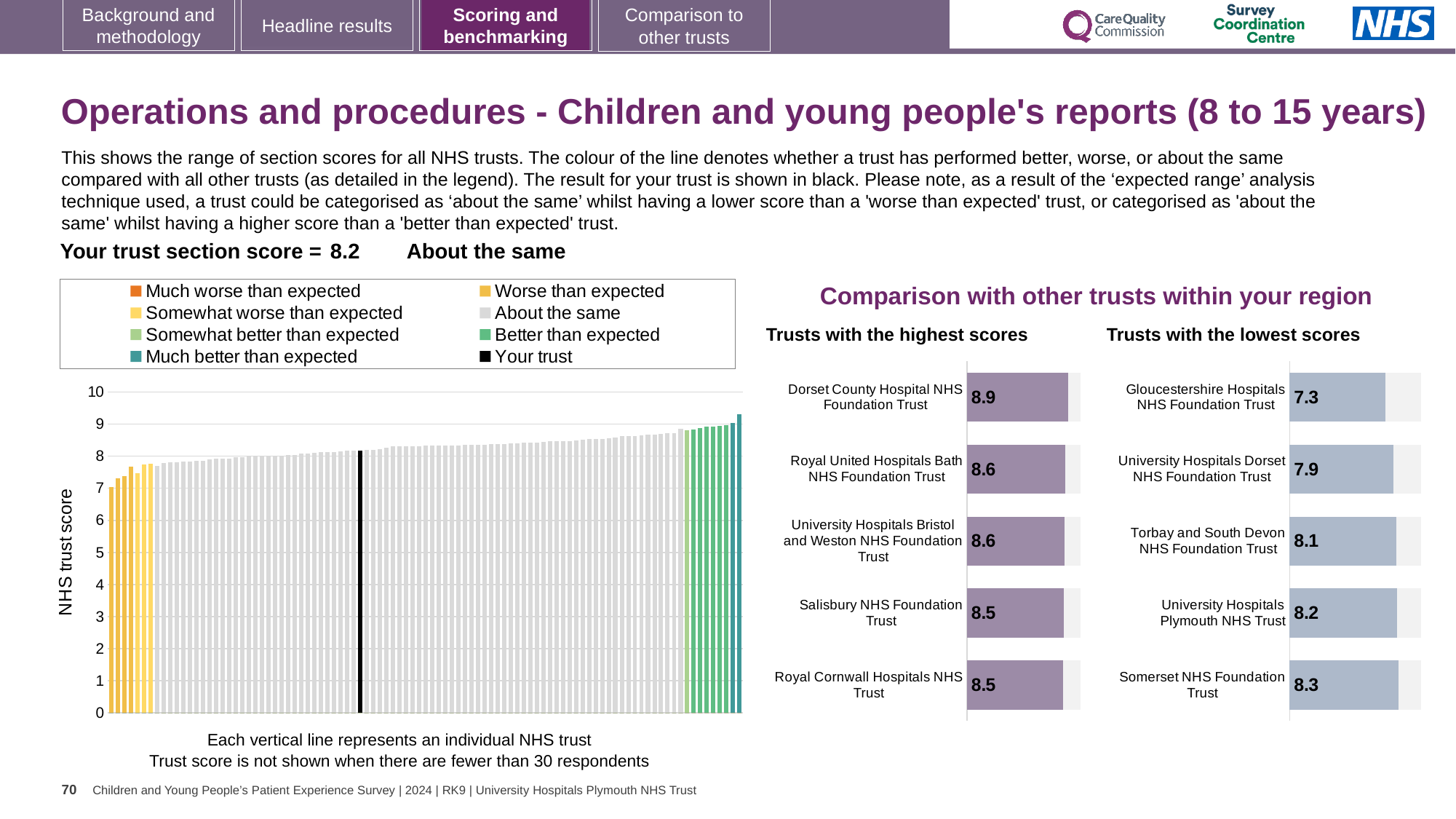
In the 'Trusts with the highest scores' chart, what is the difference between the scores of Dorset County Hospital NHS Foundation Trust and Salisbury NHS Foundation Trust? 0.4 How many trusts are shown in the 'Trusts with the highest scores' chart? 5 In the 'NHS trust score' chart on the left, is the value of the black bar (your trust) greater or less than 8? greater In the 'Trusts with the highest scores' chart, what is the score for Dorset County Hospital NHS Foundation Trust? 8.9 In the 'Trusts with the lowest scores' chart, which has the larger score: Torbay and South Devon NHS Foundation Trust or University Hospitals Dorset NHS Foundation Trust? Torbay and South Devon NHS Foundation Trust How many entries does the legend of the 'NHS trust score' bar chart on the left list? 8 In the 'NHS trust score' chart on the left, do the values rise or fall from left to right? Rise In the 'Trusts with the highest scores' chart, which trust has the highest score? Dorset County Hospital NHS Foundation Trust In the 'Trusts with the lowest scores' chart, which trust has the lowest score? Gloucestershire Hospitals NHS Foundation Trust In the 'Trusts with the lowest scores' chart, how much higher is Somerset NHS Foundation Trust's score than Gloucestershire Hospitals NHS Foundation Trust's score? 1.0 What kind of chart is the 'NHS trust score' chart on the left of the slide? Bar chart In the 'Trusts with the lowest scores' chart, what is the score for Gloucestershire Hospitals NHS Foundation Trust? 7.3